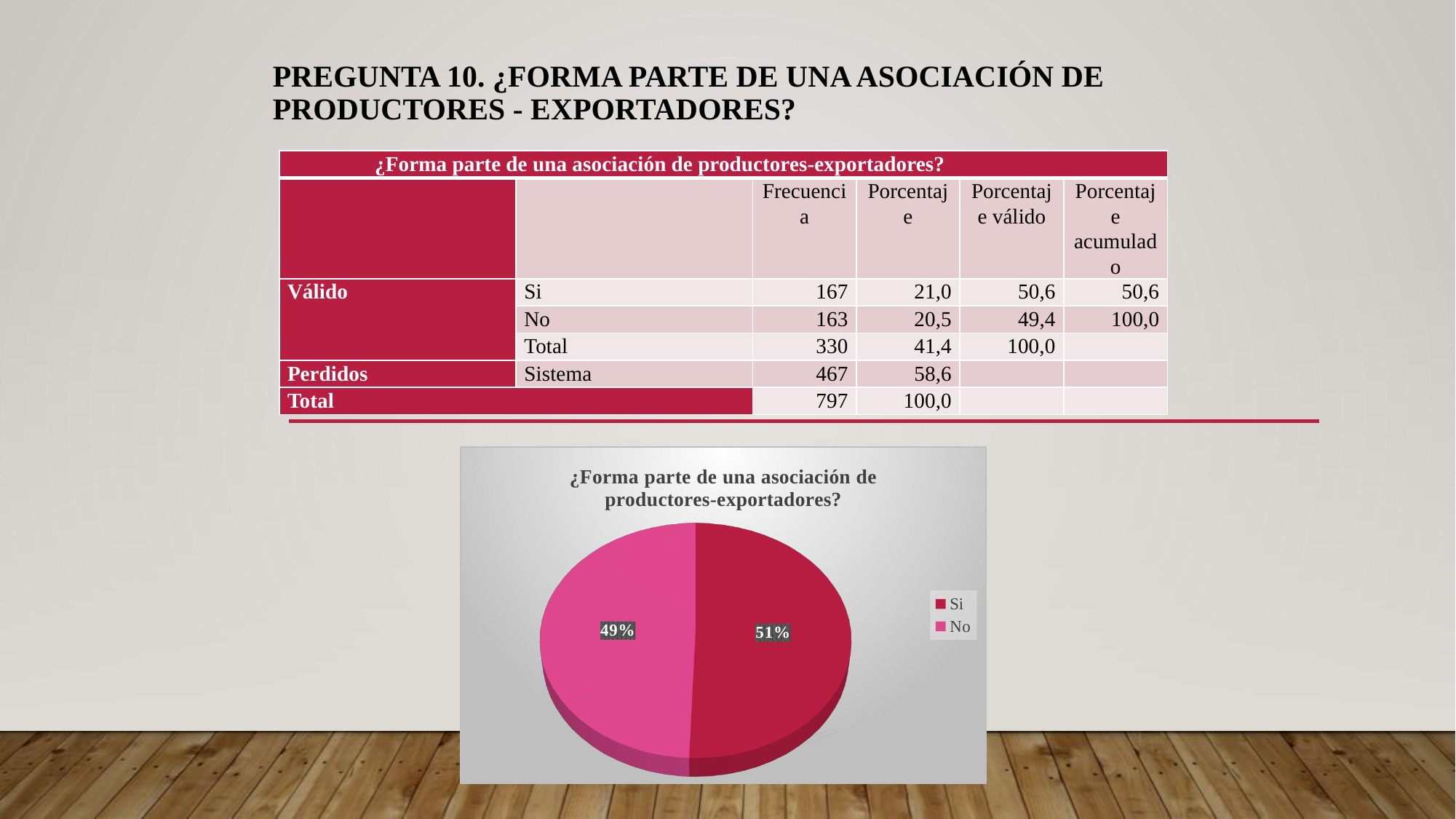
Is the 'Si' slice greater or less than 50% of the pie chart? greater What type of chart is shown on the slide? pie chart What is the difference in percentage points between the 'Si' and 'No' slices in the pie chart? 2% What is the title of the pie chart? ¿Forma parte de una asociación de productores-exportadores? Which slice of the pie chart is the smallest? No What percentage does the 'No' slice show in the pie chart? 49% How many entries does the legend of the pie chart list? 2 Which slice of the pie chart is the largest? Si How many slices does the pie chart have? 2 Which colour represents 'No' in the pie chart? pink What percentage does the 'Si' slice show in the pie chart? 51%